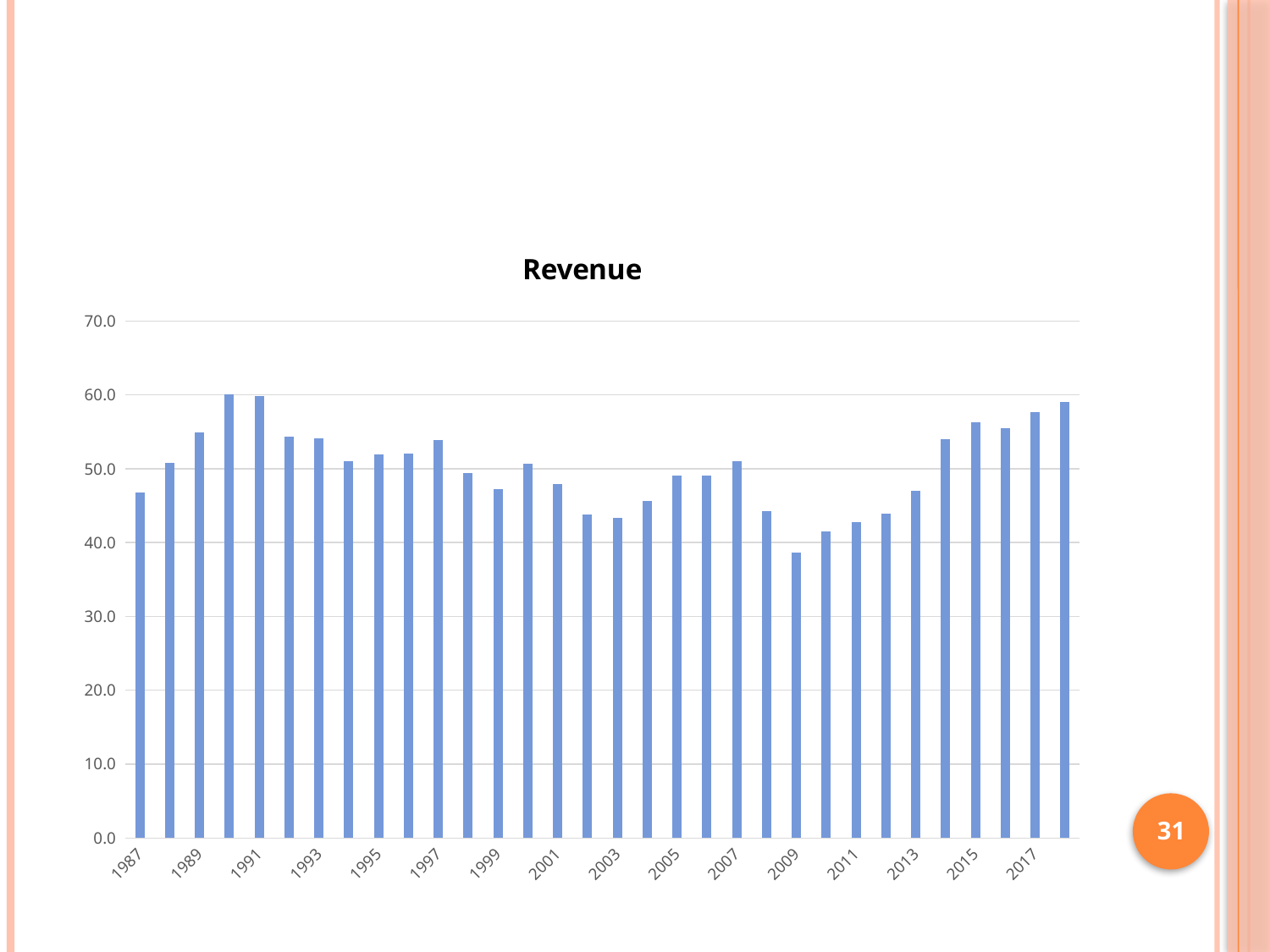
Is the value for 2017 greater or less than 50.0? greater How many bars (years) are plotted in the chart? 32 What is the title of the chart? Revenue Is the value for 2009 greater or less than 40.0? less Is the value for 1987 greater or less than 50.0? less What kind of chart is shown on the slide? bar chart Which is larger, the value for 1989 or the value for 2009? 1989 Do the values generally rise or fall from 2009 to the last bar on the right? rise Which year has the lowest revenue? 2009 Which is larger, the value for 2013 or the value for 2015? 2015